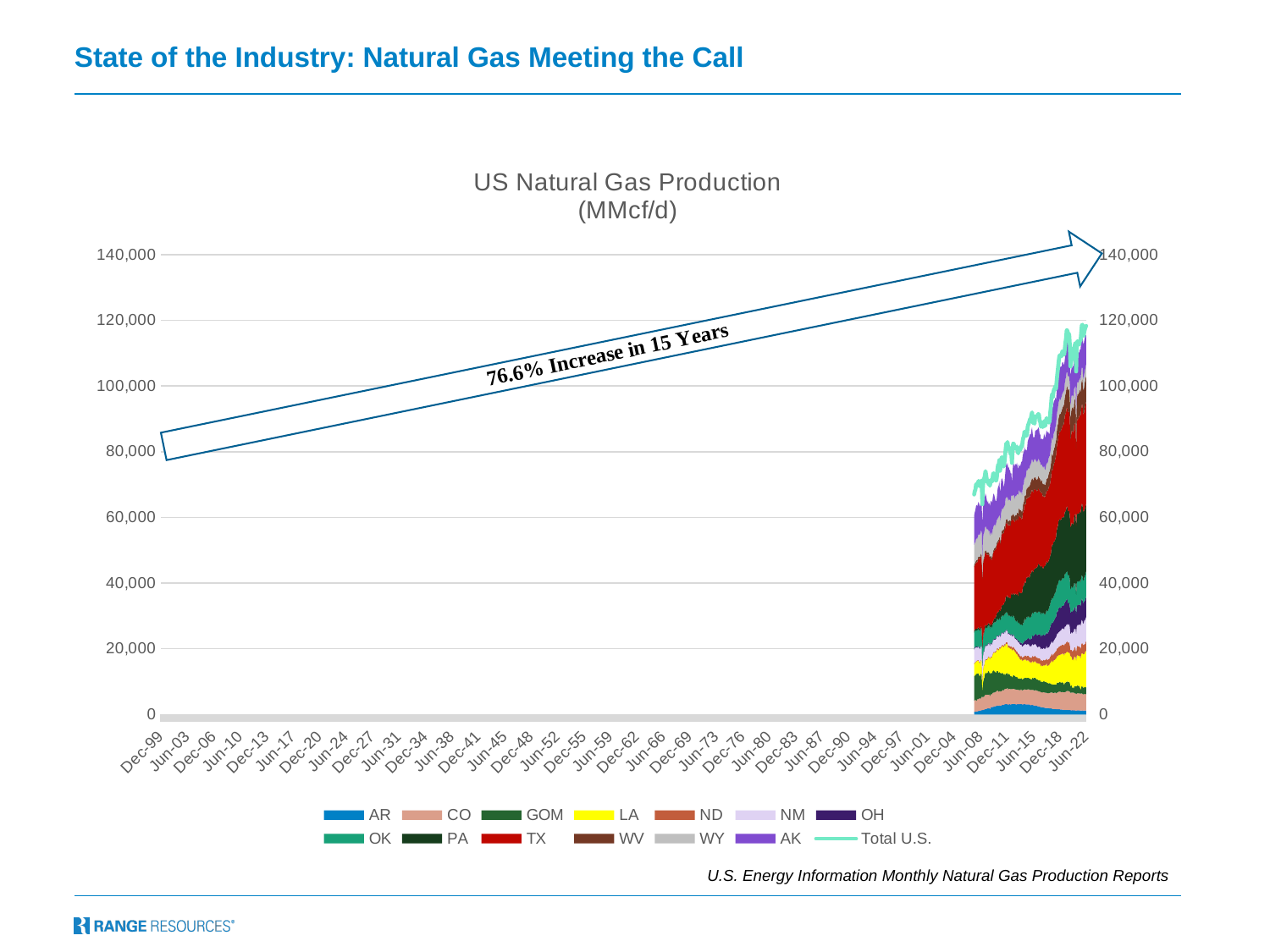
What percentage increase does the arrow annotation on the chart state? 76.6% Increase in 15 Years What is the title of the chart? US Natural Gas Production (MMcf/d) What is the highest value shown on the vertical axis? 140,000 Which legend entry is plotted as a line rather than a stacked area? Total U.S. Is the Total U.S. value at the start of the plotted data greater or less than 80,000? less Is the Total U.S. value at the right end of the chart (Jun-22) greater or less than 100,000? greater How many series does the legend list? 14 What is the lowest value shown on the vertical axis? 0 What kind of chart is shown on the slide? Stacked area chart Does the Total U.S. line rise or fall from left to right across the plotted period? Rises